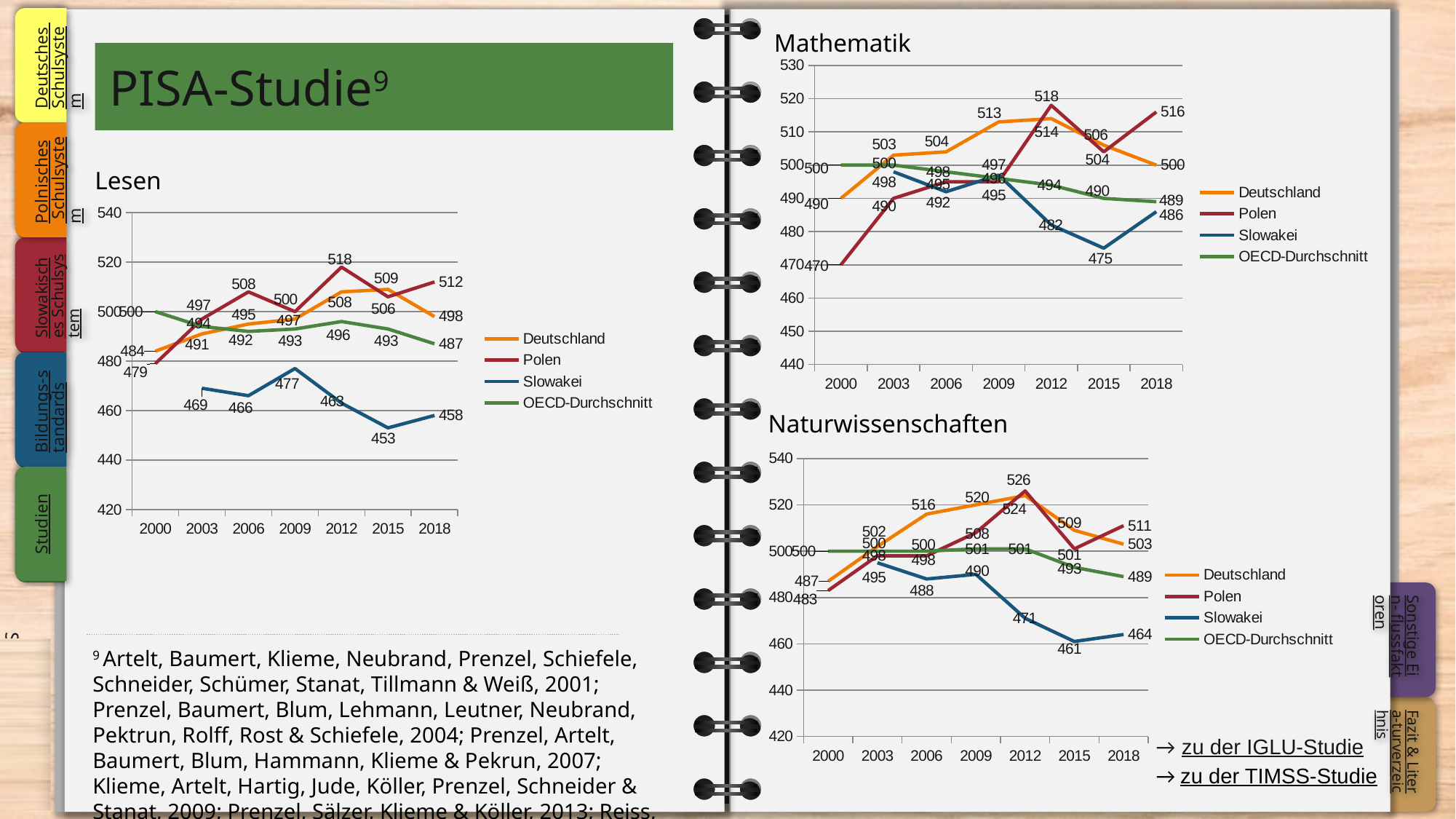
In the Lesen chart, what is the value for Slowakei in 2015? 453 In the Lesen chart, which is higher in 2018, Polen or Deutschland? Polen In the Mathematik chart, what is the difference between Polen and Deutschland in 2018? 16 How many years are shown on the x axis of the Naturwissenschaften chart? 7 In the Naturwissenschaften chart, what is the value for Slowakei in 2015? 461 In the Naturwissenschaften chart, what is the value for Polen in 2012? 526 What kind of chart is the Lesen chart? line chart In the Mathematik chart, what is the value for Polen in 2000? 470 How many series does the legend of the Mathematik chart list? 4 In the Lesen chart, in which year does Polen reach its highest value? 2012 In the Naturwissenschaften chart, does the Slowakei line rise or fall from 2009 to 2015? fall In the Mathematik chart, what is the lowest value for Slowakei? 475